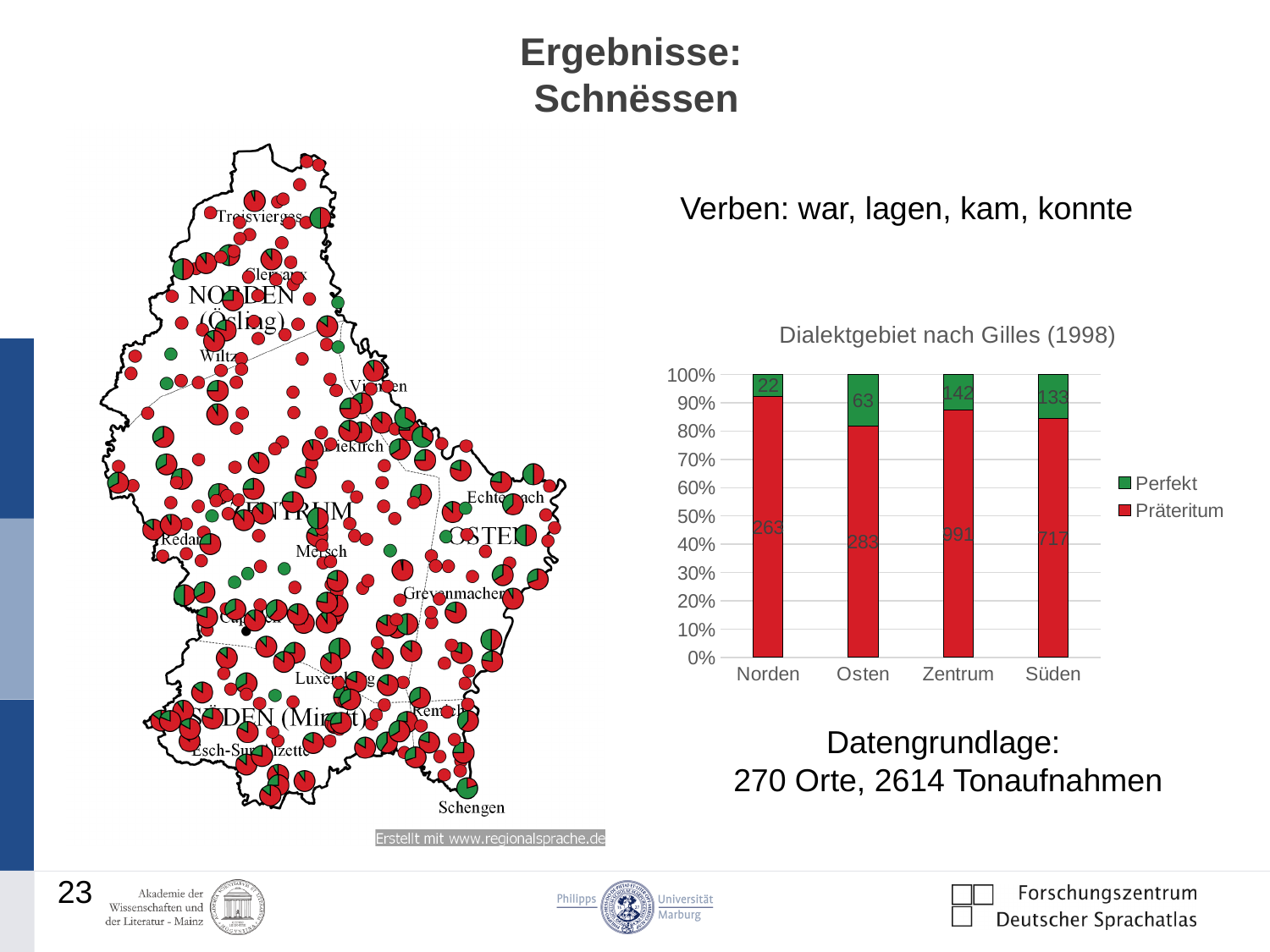
In the bar chart 'Dialektgebiet nach Gilles (1998)', which region has the highest Präteritum value? Zentrum In the bar chart 'Dialektgebiet nach Gilles (1998)', how many series does the legend list? 2 In the bar chart 'Dialektgebiet nach Gilles (1998)', what is the Präteritum value for Zentrum? 991 In the bar chart 'Dialektgebiet nach Gilles (1998)', what is the difference between the Präteritum values for Zentrum and Süden? 274 In the bar chart 'Dialektgebiet nach Gilles (1998)', what is the Perfekt value for Süden? 133 In the bar chart 'Dialektgebiet nach Gilles (1998)', which region has the lowest Perfekt value? Norden In the bar chart 'Dialektgebiet nach Gilles (1998)', what is the Perfekt value for Norden? 22 In the bar chart 'Dialektgebiet nach Gilles (1998)', what is the total of the Perfekt and Präteritum values for Osten? 346 In the bar chart 'Dialektgebiet nach Gilles (1998)', how many regions are shown on the x axis? 4 In the bar chart 'Dialektgebiet nach Gilles (1998)', which is larger: the Perfekt value for Osten or for Zentrum? Zentrum In the bar chart 'Dialektgebiet nach Gilles (1998)', which colour represents Perfekt? green What kind of chart is 'Dialektgebiet nach Gilles (1998)'? stacked bar chart